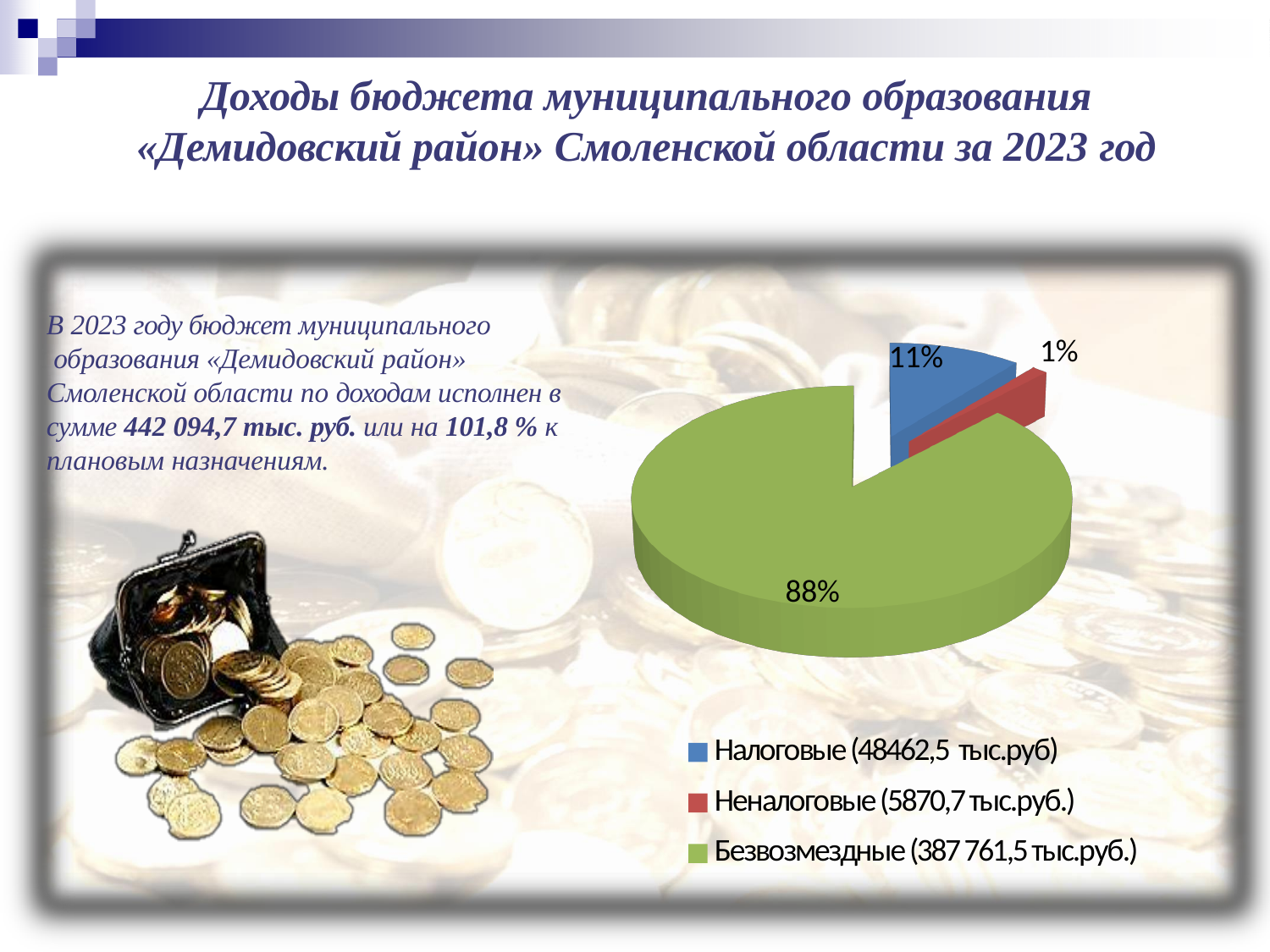
How many slices does the pie chart have? 3 How many entries does the legend of the pie chart list? 3 Which slice is larger, Налоговые or Неналоговые? Налоговые Which category has the smallest slice in the pie chart? Неналоговые What colour is the Безвозмездные slice in the pie chart? green What is the difference in percentage points between the Безвозмездные and Налоговые slices? 77 What amount in тыс.руб. is given in the legend for Налоговые? 48462,5 What share of the pie does the Налоговые slice represent? 11% What kind of chart is shown on the slide? pie chart What share of the pie does the Неналоговые slice represent? 1% What share of the pie does the Безвозмездные slice represent? 88% Which category has the largest slice in the pie chart? Безвозмездные